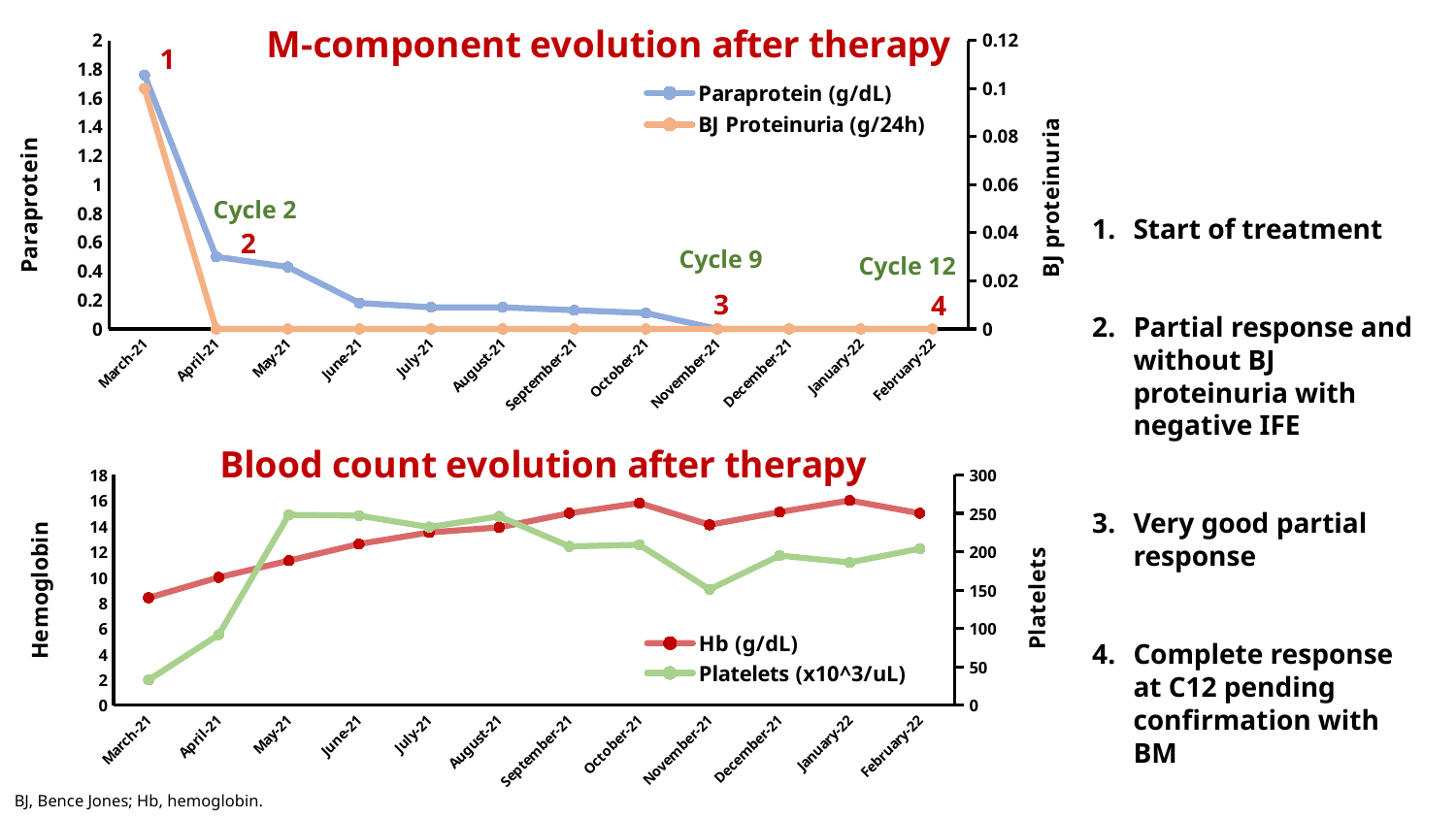
In the 'M-component evolution after therapy' chart, is the Paraprotein value for March-21 greater or less than 1.6? greater In the 'Blood count evolution after therapy' chart, is the Platelets value for March-21 greater or less than 50? less In the 'M-component evolution after therapy' chart, what is the Paraprotein value in December-21? 0 In the 'M-component evolution after therapy' chart, which month has the highest Paraprotein value? March-21 In the 'Blood count evolution after therapy' chart, which month has the lowest Hb value? March-21 What kind of chart is the 'M-component evolution after therapy' chart? line chart In the 'M-component evolution after therapy' chart, what is the BJ Proteinuria value in June-21? 0 In the 'M-component evolution after therapy' chart, does the Paraprotein series rise or fall from March-21 to November-21? fall In the 'M-component evolution after therapy' chart, how many series does the legend list? 2 In the 'Blood count evolution after therapy' chart, which series are listed in the legend? Hb (g/dL) and Platelets (x10^3/uL) In the 'M-component evolution after therapy' chart, how many months are shown on the x axis? 12 In the 'Blood count evolution after therapy' chart, is the Hb value for October-21 greater or less than 14? greater